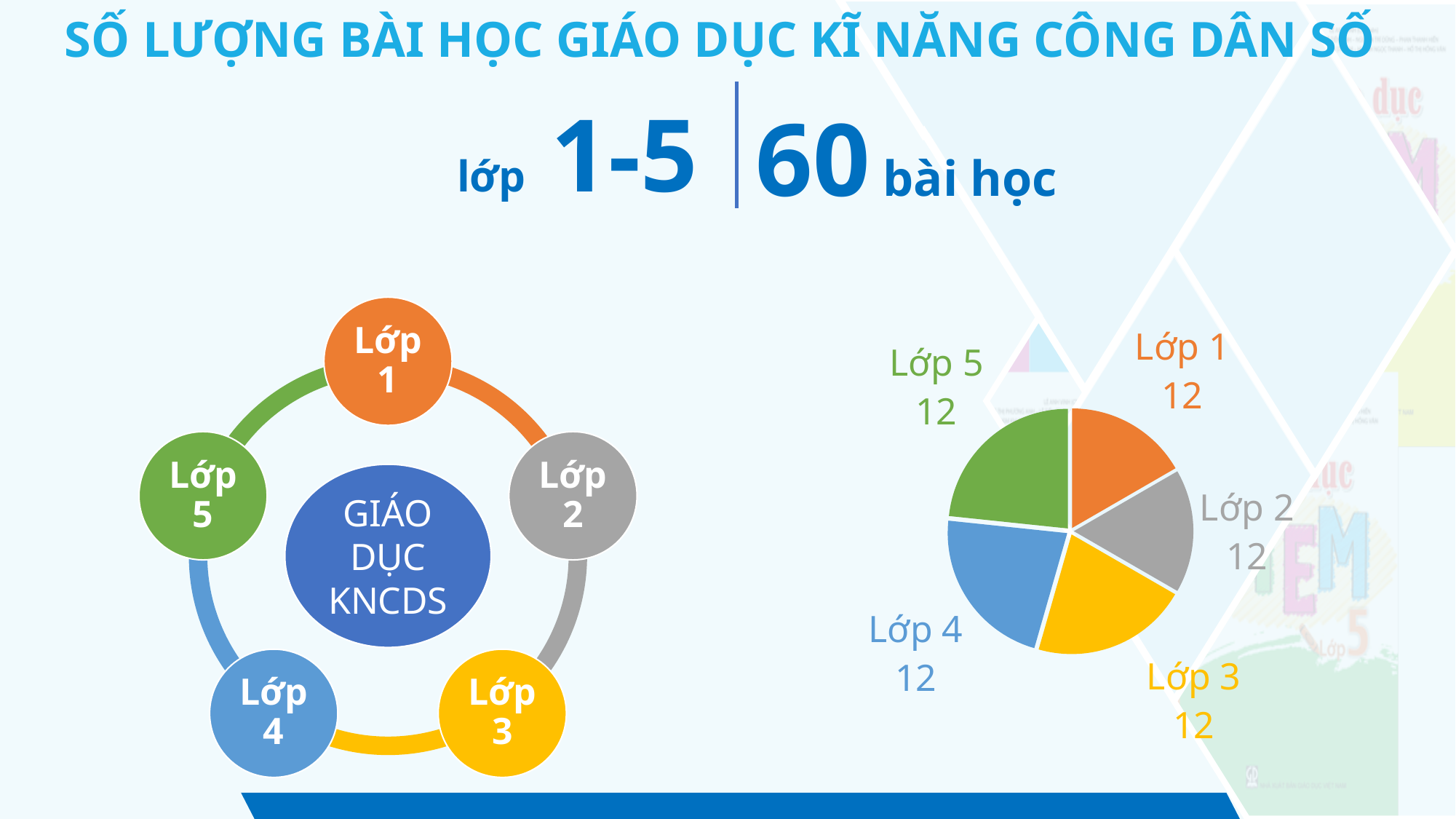
What is the value for Lớp 5 in the pie chart? 12 What is the value for Lớp 3 in the pie chart? 12 What colour is the Lớp 5 slice in the pie chart? green How many slices does the pie chart have? 5 What is the total of all the slice values in the pie chart? 60 What is the value for Lớp 4 in the pie chart? 12 What share of the pie chart does the Lớp 3 slice represent? 20% What is the value for Lớp 1 in the pie chart? 12 What is the difference between the values for Lớp 1 and Lớp 4 in the pie chart? 0 What type of chart is shown on the right side of the slide? pie chart What is the value for Lớp 2 in the pie chart? 12 What colour is the Lớp 3 slice in the pie chart? yellow